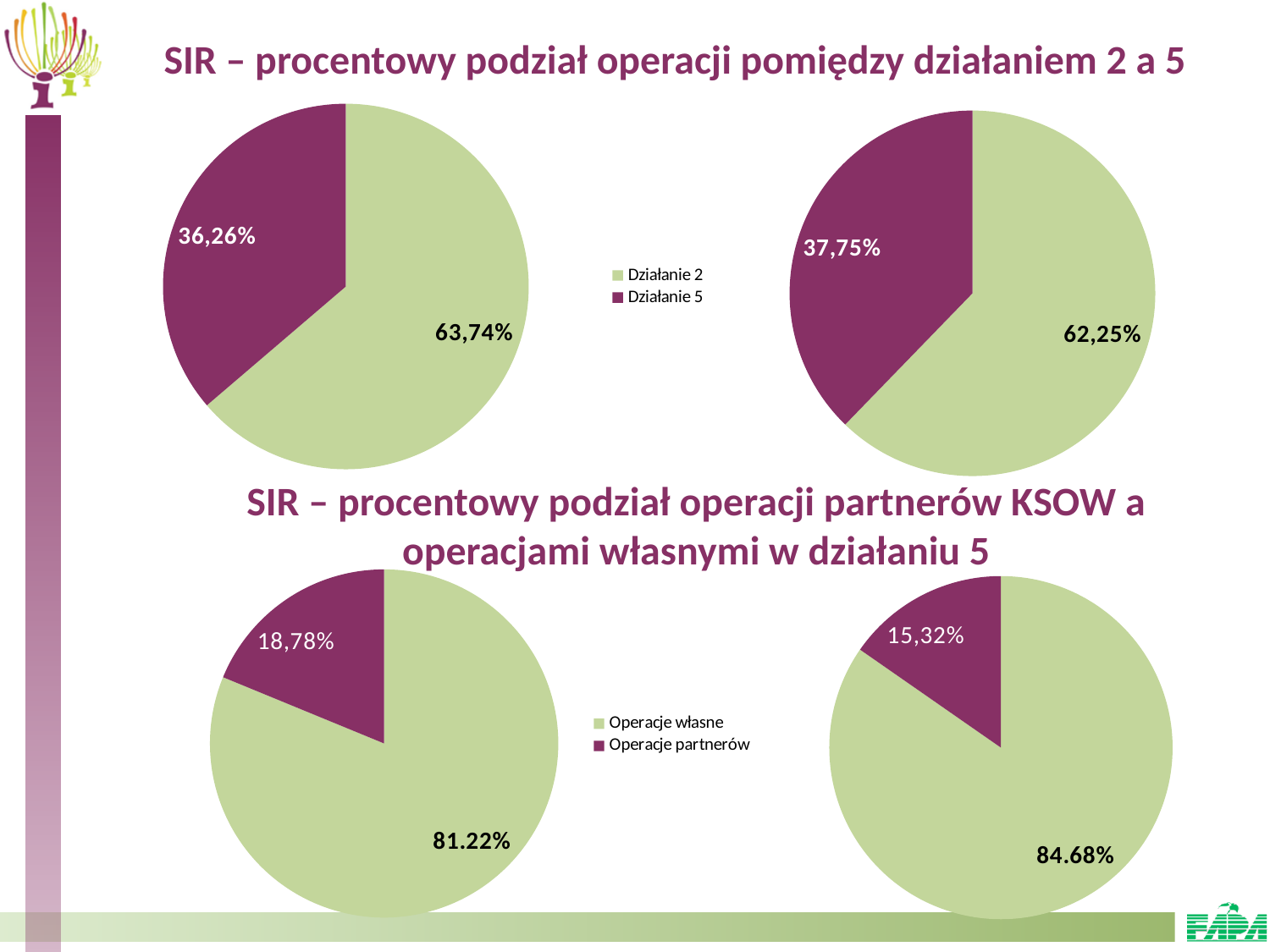
What kind of chart is the top-left chart on the slide? pie chart In the top-left pie chart, what is the difference between the Działanie 2 and Działanie 5 slices? 27,48% In the bottom-right pie chart, what is the value for Operacje partnerów? 15,32% In the top-right pie chart, what is the value for Działanie 5? 37,75% In the top-left pie chart, what is the value for Działanie 5? 36,26% In the bottom-left pie chart, what is the value for Operacje partnerów? 18,78% How many entries does the legend of the bottom pie charts list? 2 In the top-left pie chart, which category has the largest slice? Działanie 2 In the bottom-left pie chart, what is the value for Operacje własne? 81.22% In the top-left pie chart, what is the value for Działanie 2? 63,74% In the bottom-right pie chart, which category has the smallest slice? Operacje partnerów In the top-right pie chart, what is the value for Działanie 2? 62,25%